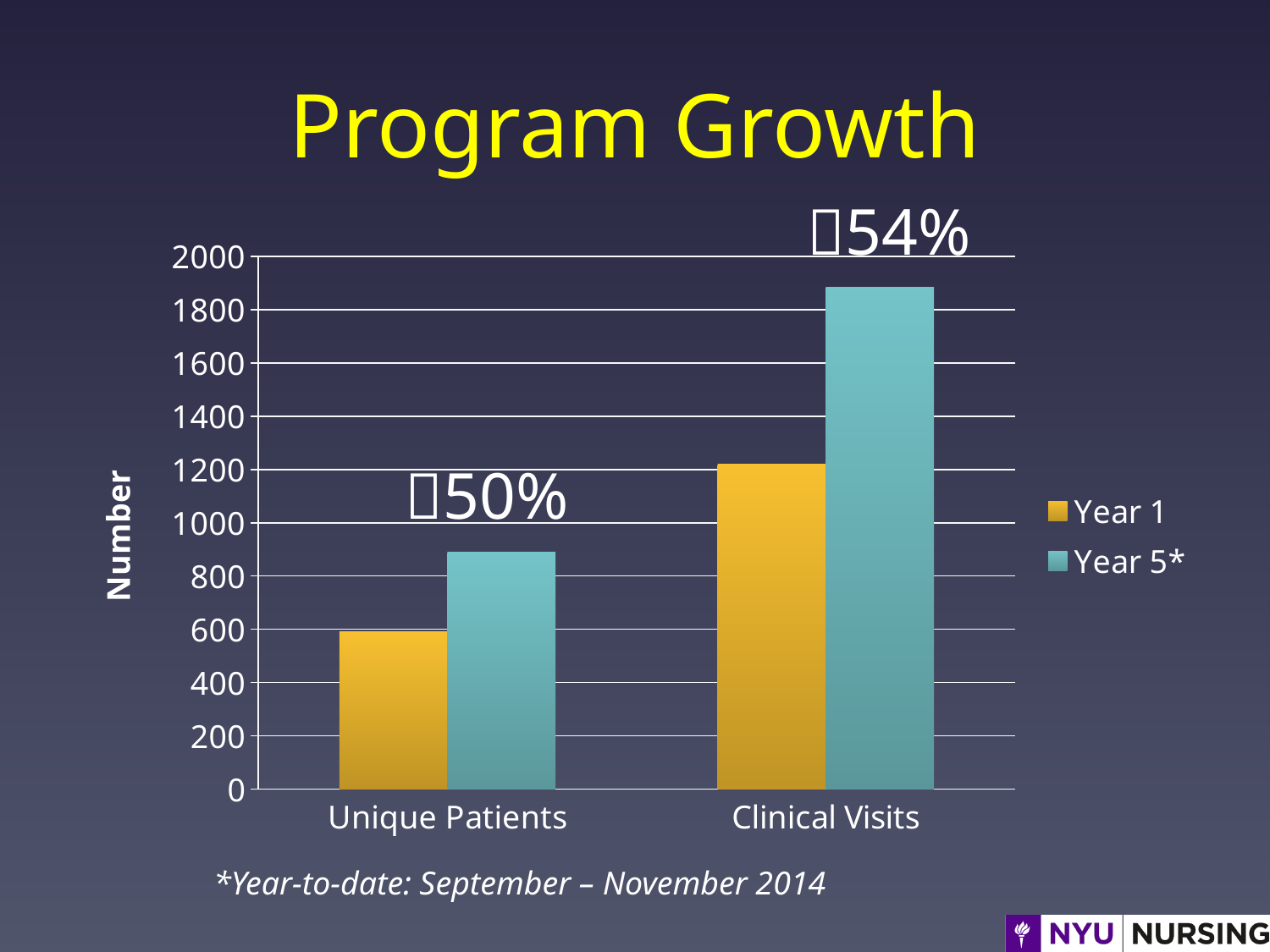
How many series does the legend list? 2 Is the Year 1 value for Unique Patients greater or less than 800? less What percentage is annotated above the Unique Patients bars? 50% What is the label on the vertical axis? Number What percentage is annotated above the Clinical Visits bars? 54% For Clinical Visits, which is larger: Year 1 or Year 5*? Year 5* Which bar is the shortest in the chart? Year 1 Unique Patients How many categories are shown on the x axis? 2 What is the title of the chart? Program Growth Which bar is the tallest in the chart? Year 5* Clinical Visits Is the Year 5* value for Clinical Visits greater or less than 1600? greater What kind of chart is shown on the slide? bar chart